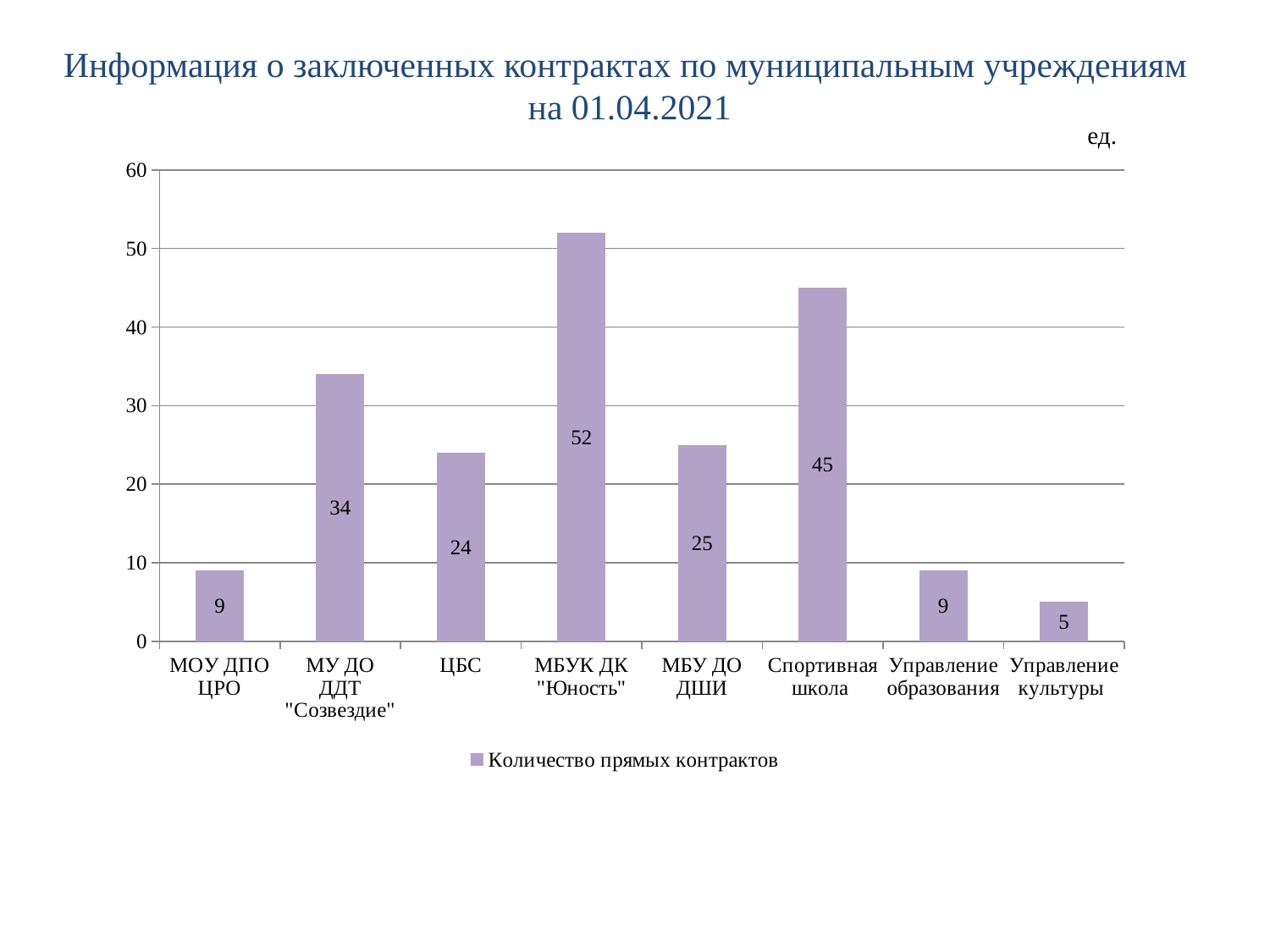
How many series does the legend list? 1 What is the difference between the values for МБУК ДК "Юность" and Спортивная школа? 7 How many categories are shown on the x axis? 8 What is the value for МБУК ДК "Юность"? 52 What is the legend entry for the series? Количество прямых контрактов What kind of chart is shown on the slide? bar chart What is the value for Спортивная школа? 45 Which category has the lowest value? Управление культуры Is the value for Спортивная школа greater or less than 40? greater Which category has the highest value? МБУК ДК "Юность" Which is larger, the value for МУ ДО ДДТ "Созвездие" or the value for МБУ ДО ДШИ? МУ ДО ДДТ "Созвездие" What is the value for ЦБС? 24